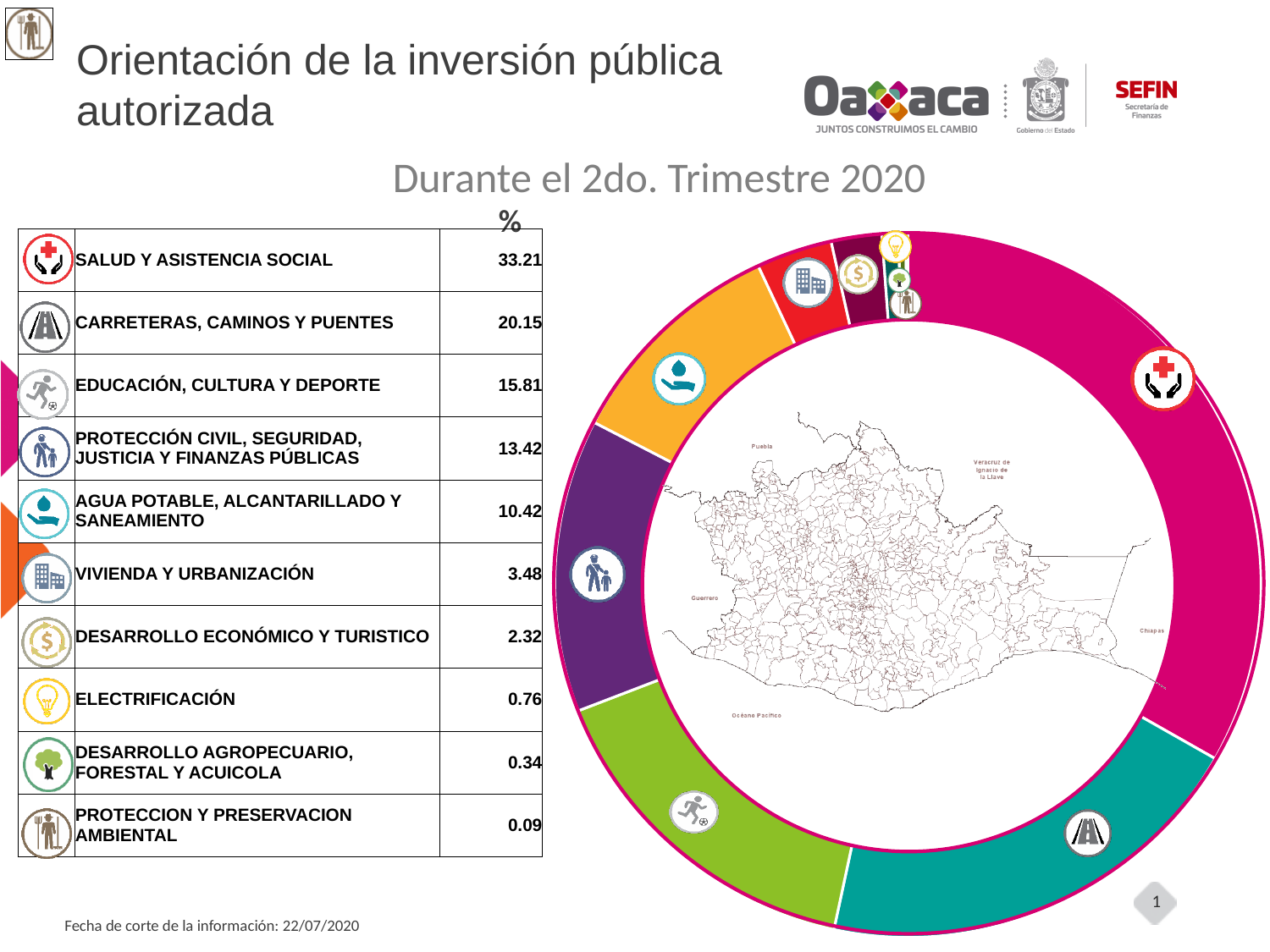
Which category has the largest share of the authorized public investment? SALUD Y ASISTENCIA SOCIAL How many categories are listed for the authorized public investment? 10 What type of chart is shown on the slide? Pie chart (donut) What is the difference in percentage points between VIVIENDA Y URBANIZACIÓN and DESARROLLO ECONÓMICO Y TURISTICO? 1.16 What percentage is shown for ELECTRIFICACIÓN? 0.76 What percentage is shown for SALUD Y ASISTENCIA SOCIAL? 33.21 What is the difference in percentage points between SALUD Y ASISTENCIA SOCIAL and CARRETERAS, CAMINOS Y PUENTES? 13.06 What percentage is shown for AGUA POTABLE, ALCANTARILLADO Y SANEAMIENTO? 10.42 Which category has the smallest share of the authorized public investment? PROTECCION Y PRESERVACION AMBIENTAL What percentage is shown for CARRETERAS, CAMINOS Y PUENTES? 20.15 Which is larger, the share for EDUCACIÓN, CULTURA Y DEPORTE or the share for PROTECCIÓN CIVIL, SEGURIDAD, JUSTICIA Y FINANZAS PÚBLICAS? EDUCACIÓN, CULTURA Y DEPORTE What period does the chart cover, according to the subtitle? Durante el 2do. Trimestre 2020